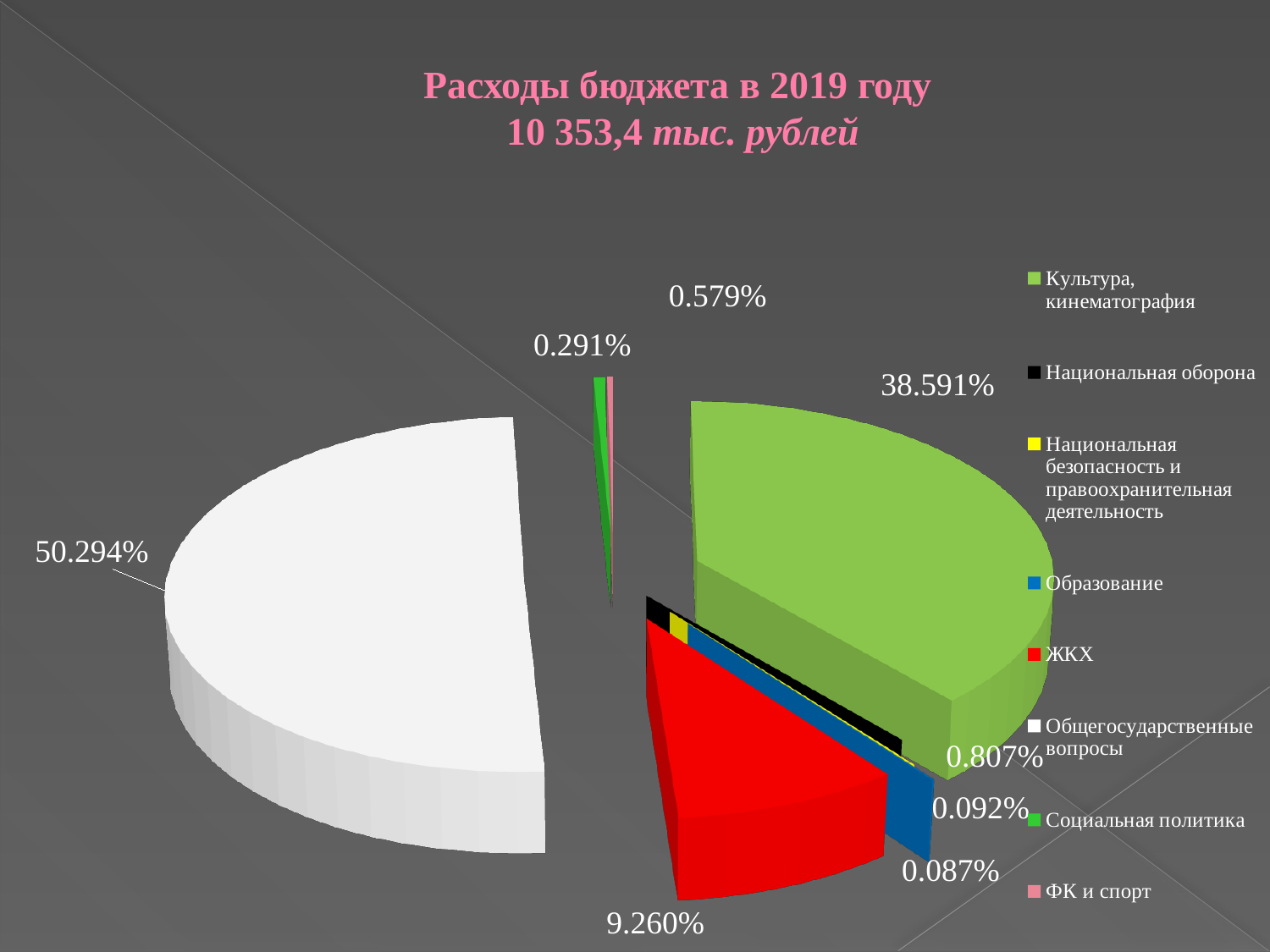
What share of the pie is ФК и спорт? 0.291% What share of the pie is Общегосударственные вопросы? 50.294% What kind of chart is shown on the slide? pie chart Which is larger, the slice for ЖКХ or the slice for Культура, кинематография? Культура, кинематография What share of the pie is ЖКХ? 9.260% How many categories does the legend list? 8 What is the difference between the shares of Общегосударственные вопросы and Культура, кинематография? 11.703% What is the title of the chart? Расходы бюджета в 2019 году 10 353,4 тыс. рублей Which category has the largest slice? Общегосударственные вопросы What is the smallest percentage labelled on the chart? 0.087%